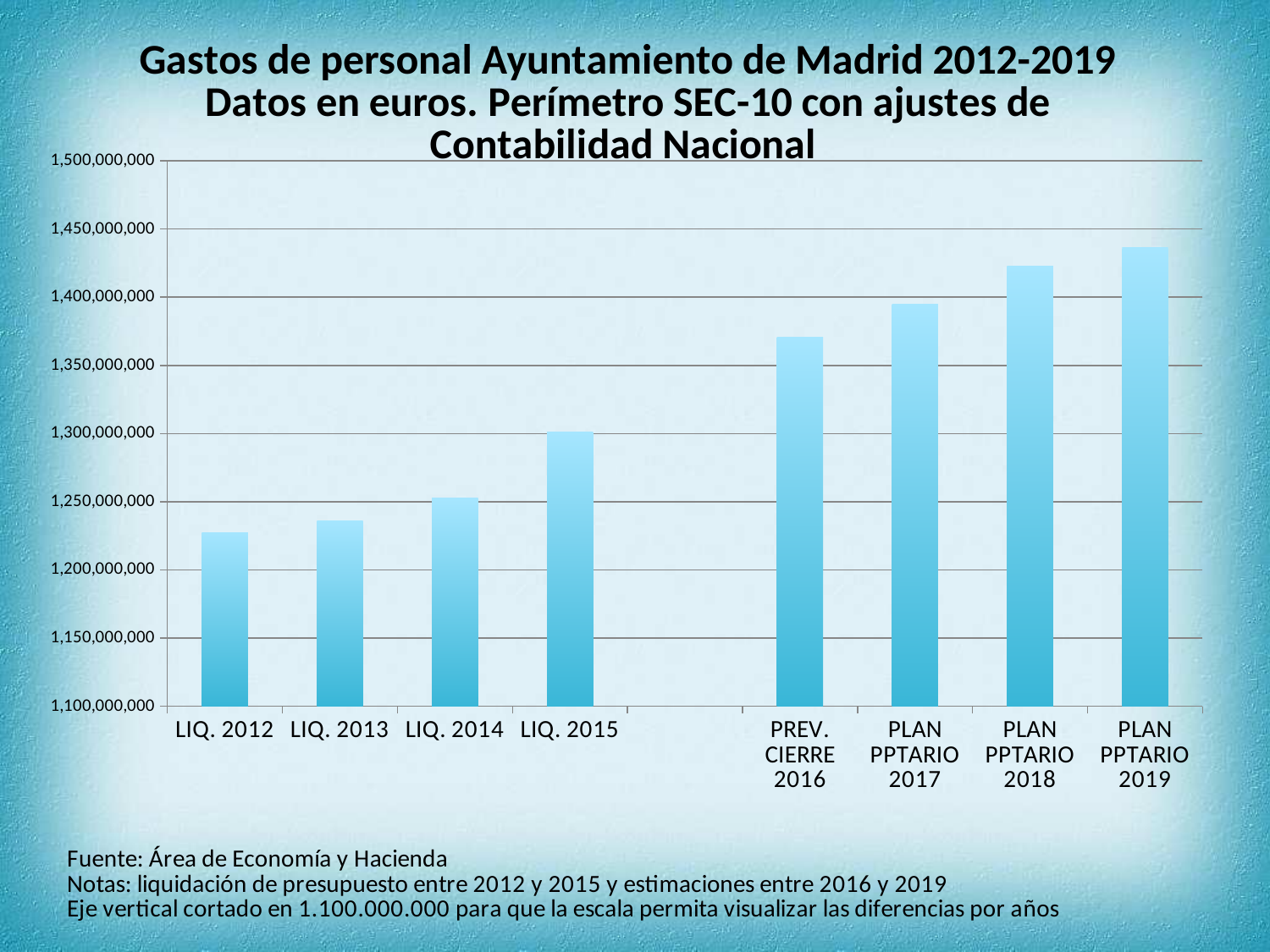
Is the value for PLAN PPTARIO 2019 greater or less than 1,400,000,000? greater Is the value for LIQ. 2012 greater or less than 1,250,000,000? less How many bars (categories) are plotted in the chart? 8 Is the value for LIQ. 2015 greater or less than 1,350,000,000? less Which is larger, the value for LIQ. 2012 or the value for LIQ. 2014? LIQ. 2014 What kind of chart is shown on the slide? Bar chart Which category has the highest value? PLAN PPTARIO 2019 At what value does the vertical axis of the chart start? 1,100,000,000 Which is larger, the value for LIQ. 2015 or the value for PREV. CIERRE 2016? PREV. CIERRE 2016 Which category has the lowest value? LIQ. 2012 Do the values rise or fall from LIQ. 2012 to PLAN PPTARIO 2019? Rise